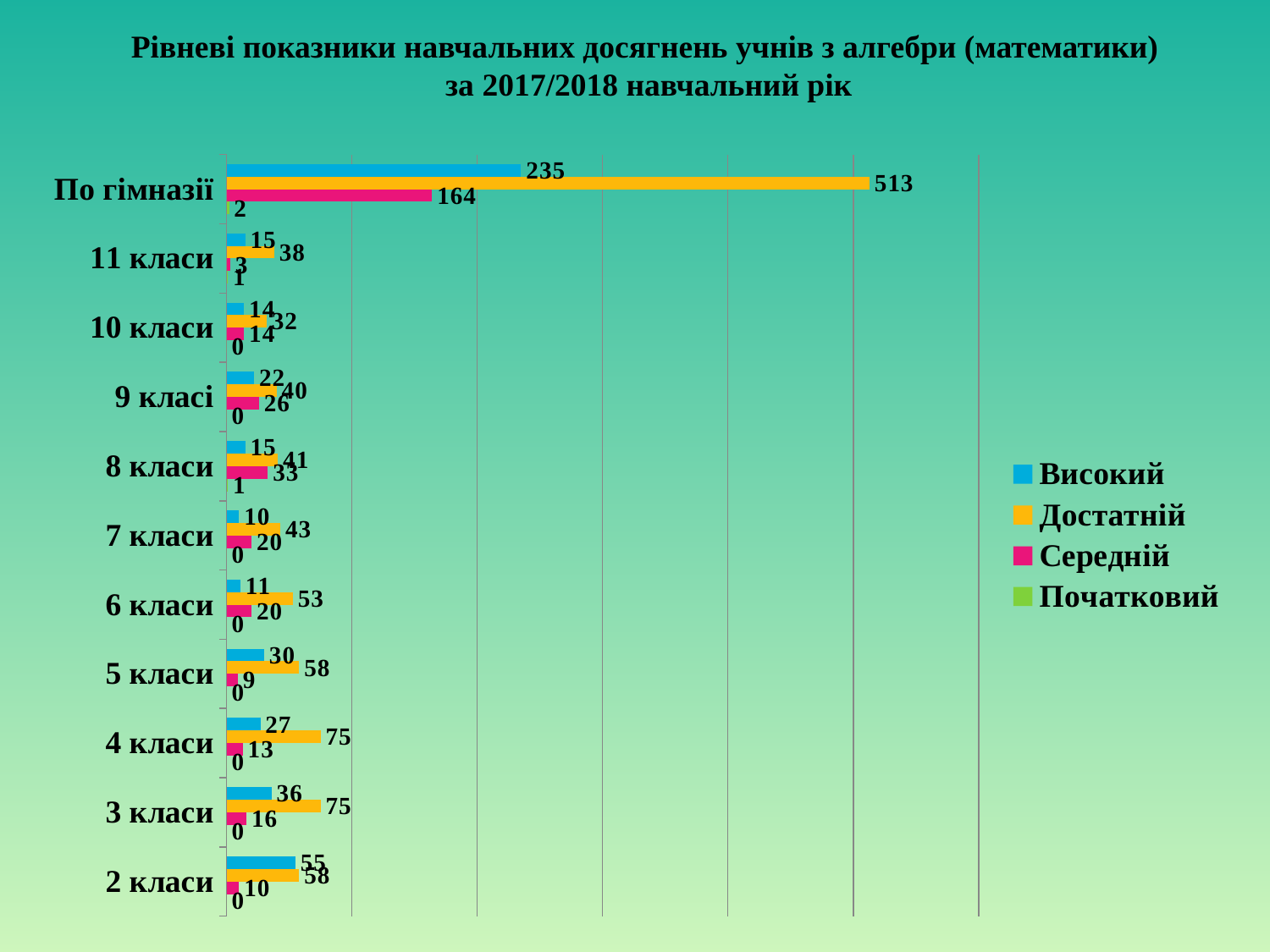
Among the class categories (excluding По гімназії), which has the lowest Достатній value? 10 класи What is the value of Високий for 2 класи? 55 Which category has the highest Високий value? По гімназії Which is larger for 9 класі: the Високий value or the Середній value? Середній How many categories are shown on the y axis? 11 What is the value of Початковий for 11 класи? 1 How many series does the legend list? 4 What is the value of Середній for 8 класи? 33 What kind of chart is shown on the slide? bar chart What is the difference between the Достатній and Високий values for По гімназії? 278 Which series is shown in pink/magenta in the legend? Середній What is the value of Достатній for По гімназії? 513